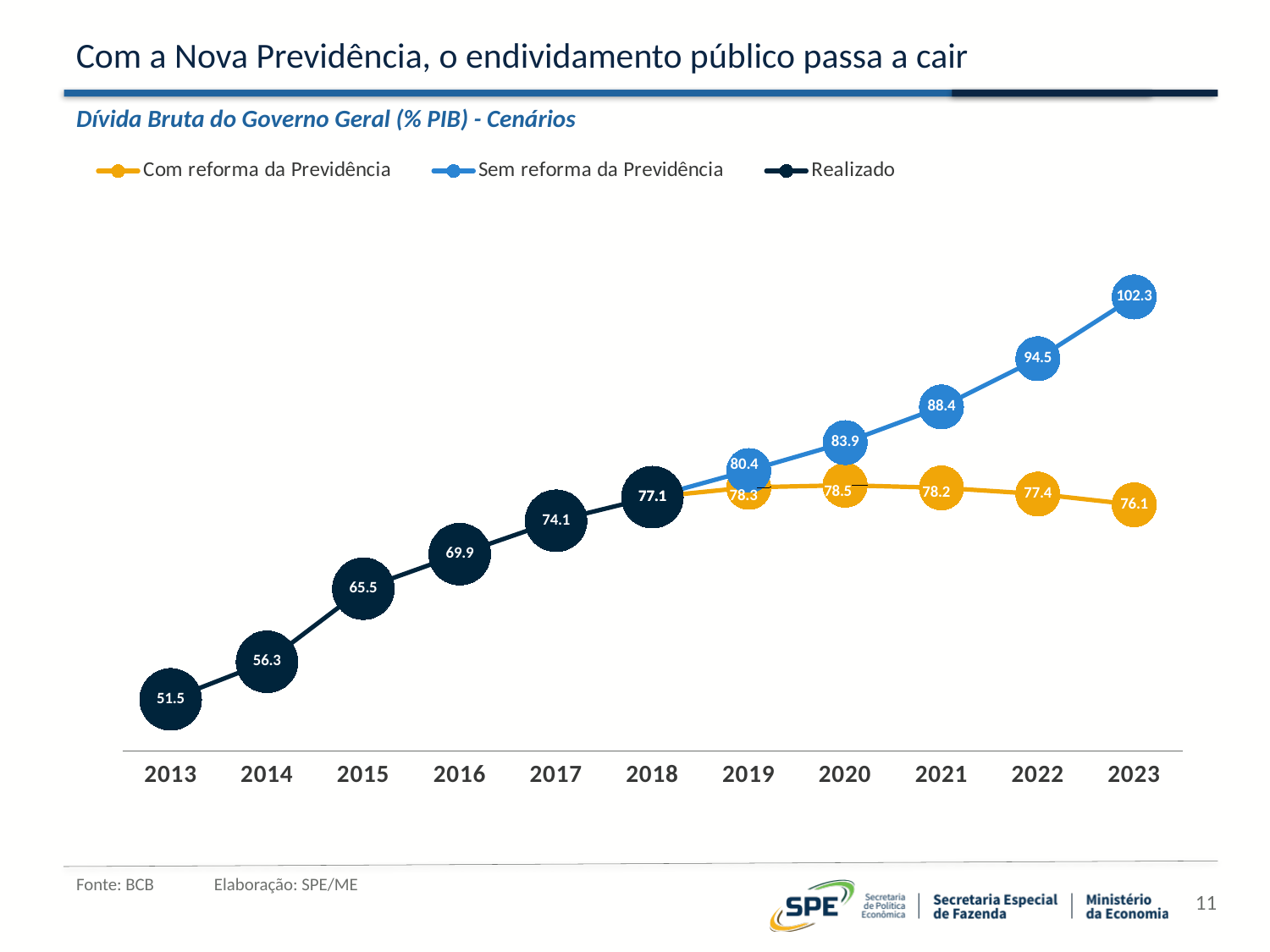
Which is larger in 2020: the Sem reforma da Previdência value or the Com reforma da Previdência value? Sem reforma da Previdência What is the difference between the Sem reforma da Previdência and Com reforma da Previdência values in 2023? 26.2 In which year does the Realizado series have its lowest value? 2013 Does the Com reforma da Previdência series rise or fall from 2020 to 2023? Fall What is the value for Realizado in 2013? 51.5 How many series does the legend list? 3 What is the value for Com reforma da Previdência in 2021? 78.2 What is the value for Realizado in 2018? 77.1 How many years are shown on the x axis? 11 What is the value for Sem reforma da Previdência in 2023? 102.3 What kind of chart is shown on the slide? Line chart In which year does the Sem reforma da Previdência series reach its highest value? 2023